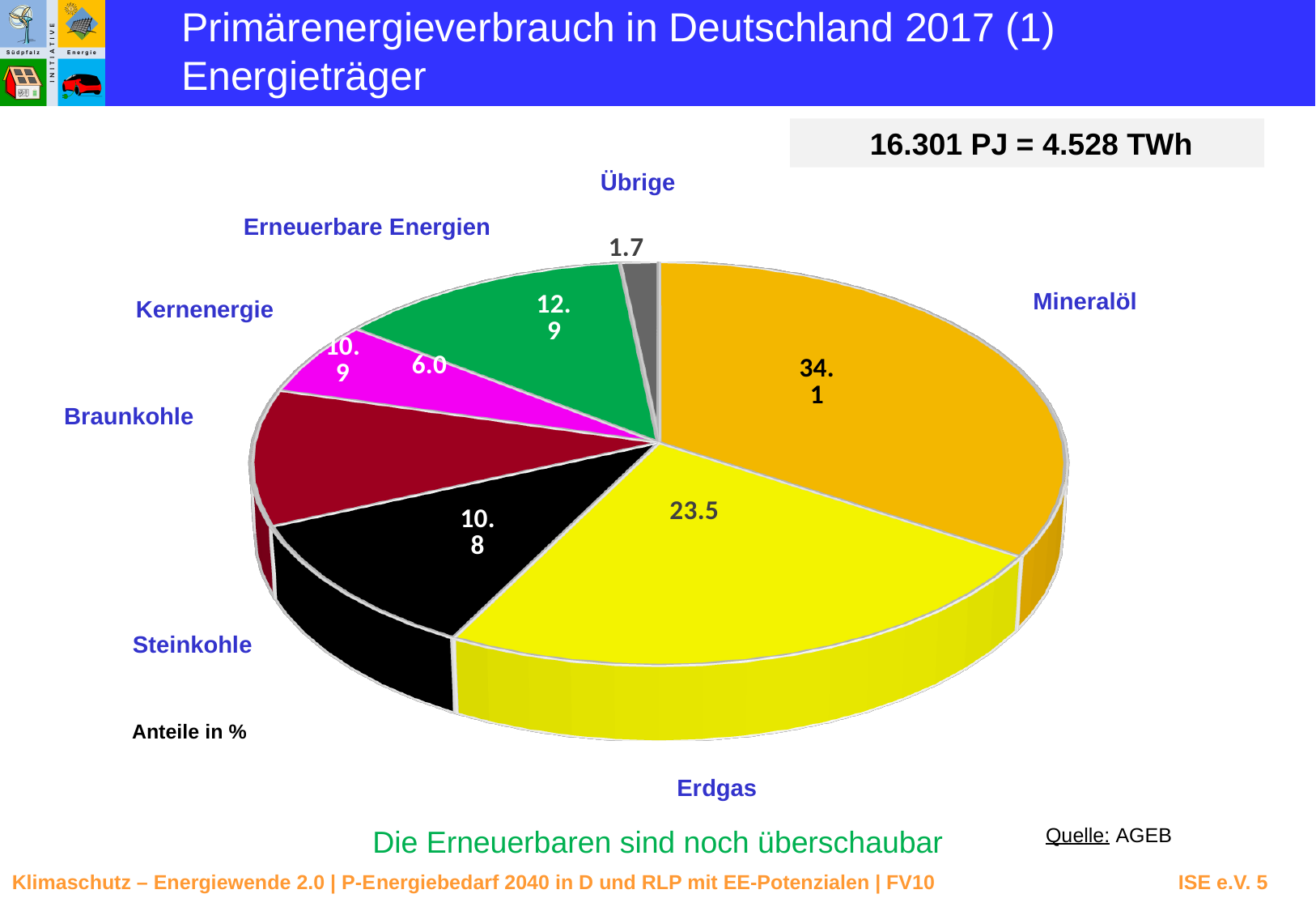
Which energy source has the largest slice of the pie? Mineralöl What total primary energy consumption is stated above the chart? 16.301 PJ = 4.528 TWh What is the share for Erneuerbare Energien? 12.9 What is the share for Mineralöl? 34.1 What is the difference between the shares of Mineralöl and Erdgas? 10.6 Which energy source has the smallest slice of the pie? Übrige What kind of chart is shown on the slide? pie chart What is the share for Übrige? 1.7 What is the share for Steinkohle? 10.8 What is the share for Erdgas? 23.5 How many categories are shown in the pie chart? 7 Which is larger, the slice for Braunkohle or the slice for Kernenergie? Braunkohle